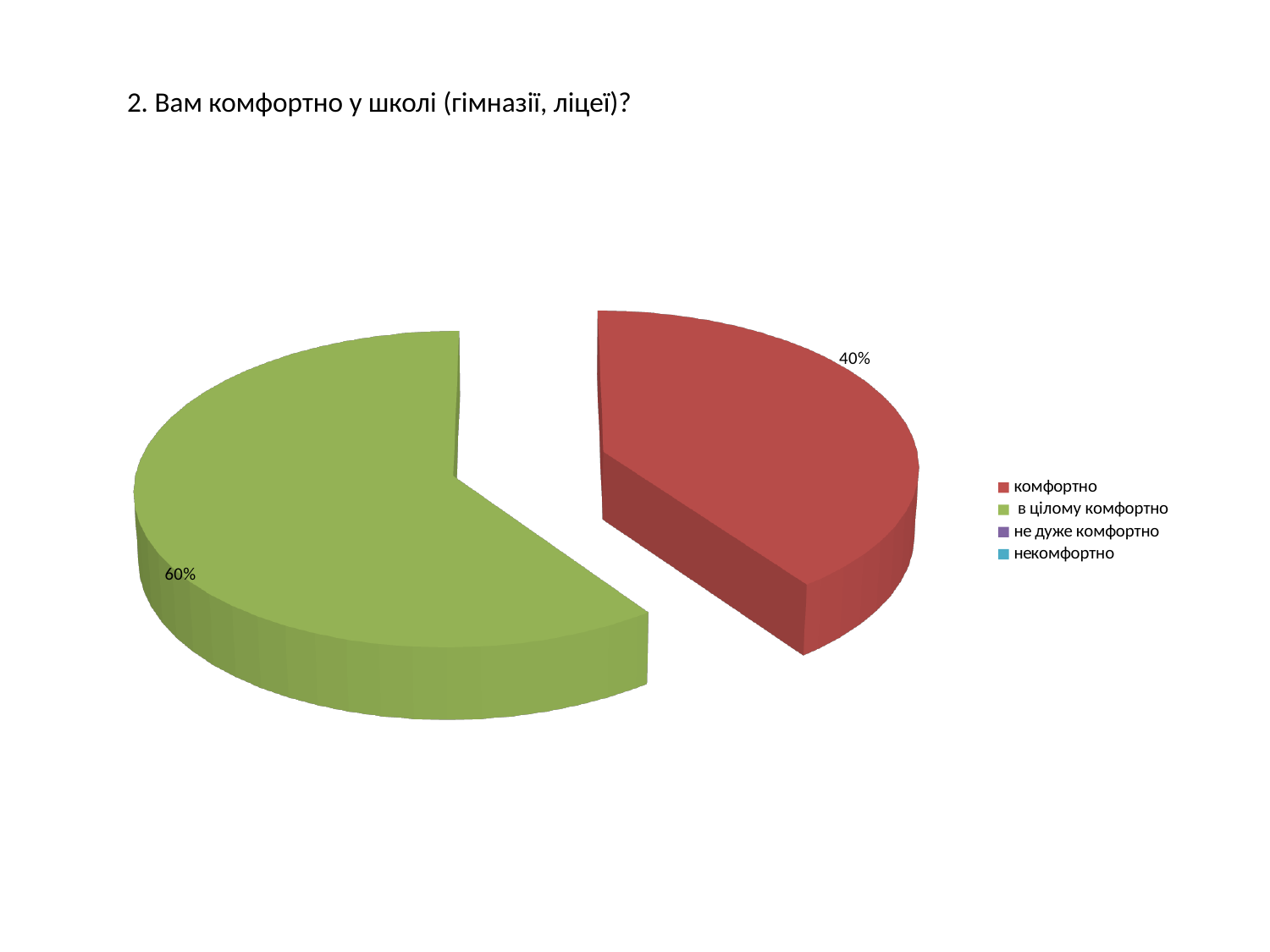
What colour is the 'комфортно' slice? red What share of the pie does the 'комфортно' slice represent? 40% What colour is the 'в цілому комфортно' slice? green How many entries does the legend list? 4 How many slices are visible in the pie? 2 What kind of chart is shown on the slide? pie chart Which category has the largest slice of the pie? в цілому комфортно What share of the pie does the 'в цілому комфортно' slice represent? 60% What is the difference in percentage points between the 'в цілому комфортно' and 'комфортно' slices? 20% Which is larger, the 'комфортно' slice or the 'в цілому комфортно' slice? в цілому комфортно Is the share for 'комфортно' greater or less than 50%? less